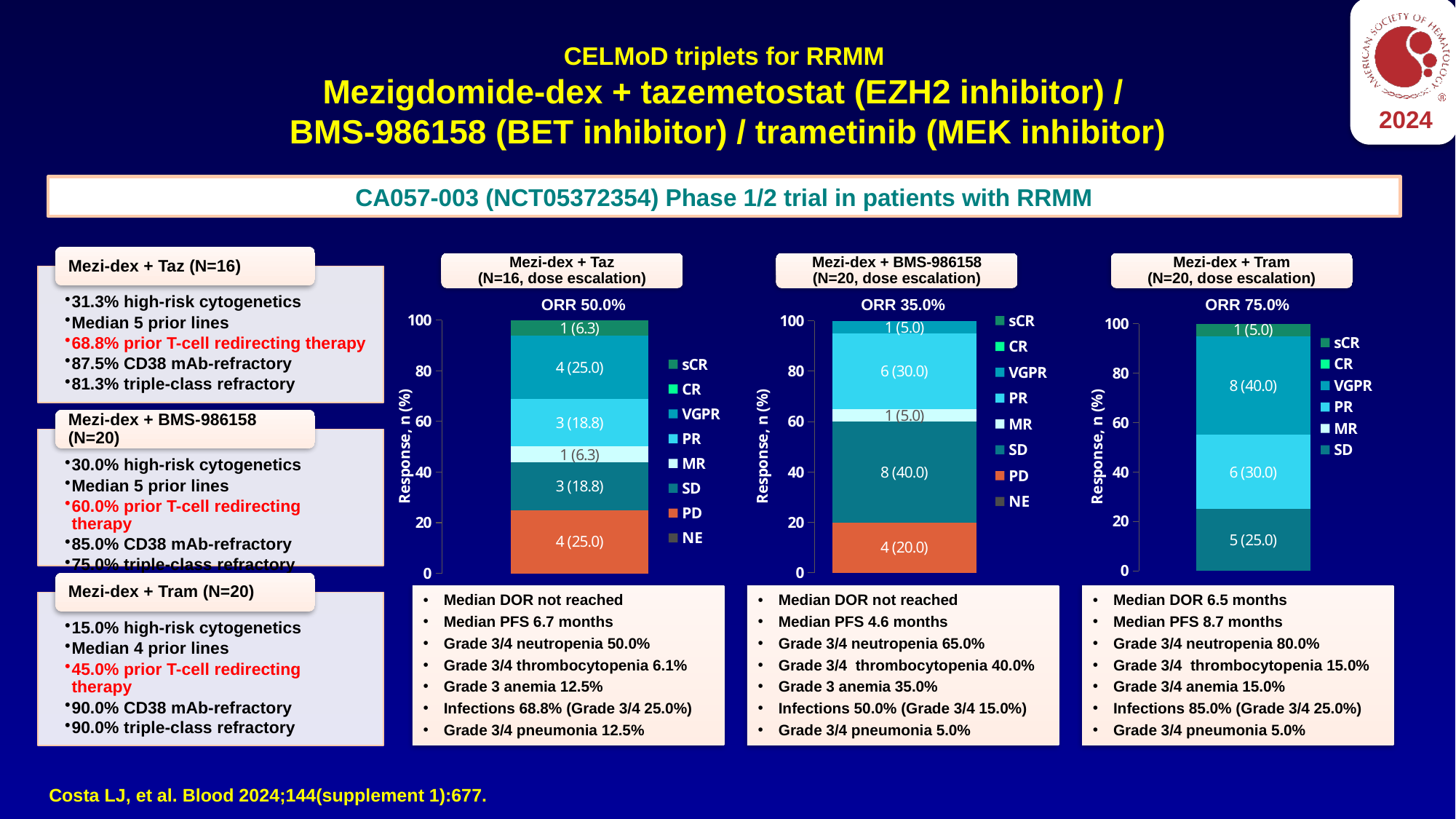
What ORR is reported above the Mezi-dex + BMS-986158 chart? ORR 35.0% In the Mezi-dex + Tram chart, which response category has the largest segment? VGPR In the Mezi-dex + Taz chart, is the PR segment larger or smaller than the PD segment? Smaller In the Mezi-dex + Tram chart, what is the difference in percentage points between the VGPR segment and the SD segment? 15.0 What ORR is reported above the Mezi-dex + Tram chart? ORR 75.0% In the Mezi-dex + Taz chart, what is the value shown for the PD segment? 4 (25.0) In the Mezi-dex + BMS-986158 chart, what is the value shown for the SD segment? 8 (40.0) How many entries does the legend of the Mezi-dex + Tram chart list? 6 How many entries does the legend of the Mezi-dex + Taz chart list? 8 What type of chart is used to show the response data for each treatment arm? Stacked bar chart In the Mezi-dex + BMS-986158 chart, which response category has the largest segment? SD In the Mezi-dex + Tram chart, what is the value shown for the VGPR segment? 8 (40.0)